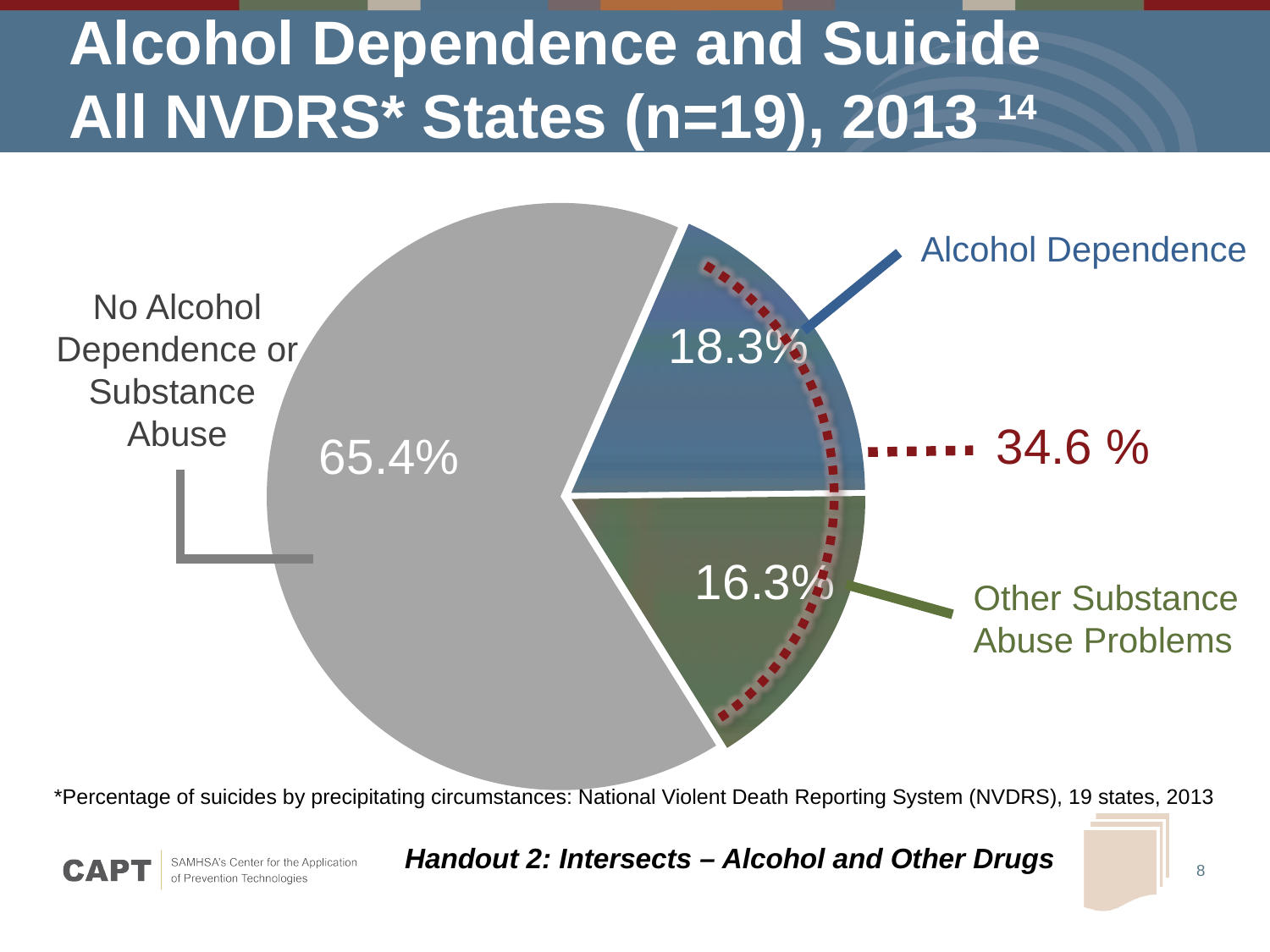
Which slice of the pie is the largest? No Alcohol Dependence or Substance Abuse What percentage of the pie is labelled for No Alcohol Dependence or Substance Abuse? 65.4% Which slice of the pie is the smallest? Other Substance Abuse Problems How many slices does the pie chart have? 3 What percentage of the pie is labelled for Other Substance Abuse Problems? 16.3% Which is larger, the Alcohol Dependence slice or the Other Substance Abuse Problems slice? Alcohol Dependence What colour is the No Alcohol Dependence or Substance Abuse slice? Grey What is the title of the slide containing the chart? Alcohol Dependence and Suicide All NVDRS* States (n=19), 2013 What combined percentage is shown for the Alcohol Dependence and Other Substance Abuse Problems slices together? 34.6 % What percentage of the pie is labelled for Alcohol Dependence? 18.3% What kind of chart is shown on the slide? Pie chart What is the difference in percentage points between the Alcohol Dependence slice and the Other Substance Abuse Problems slice? 2.0 percentage points